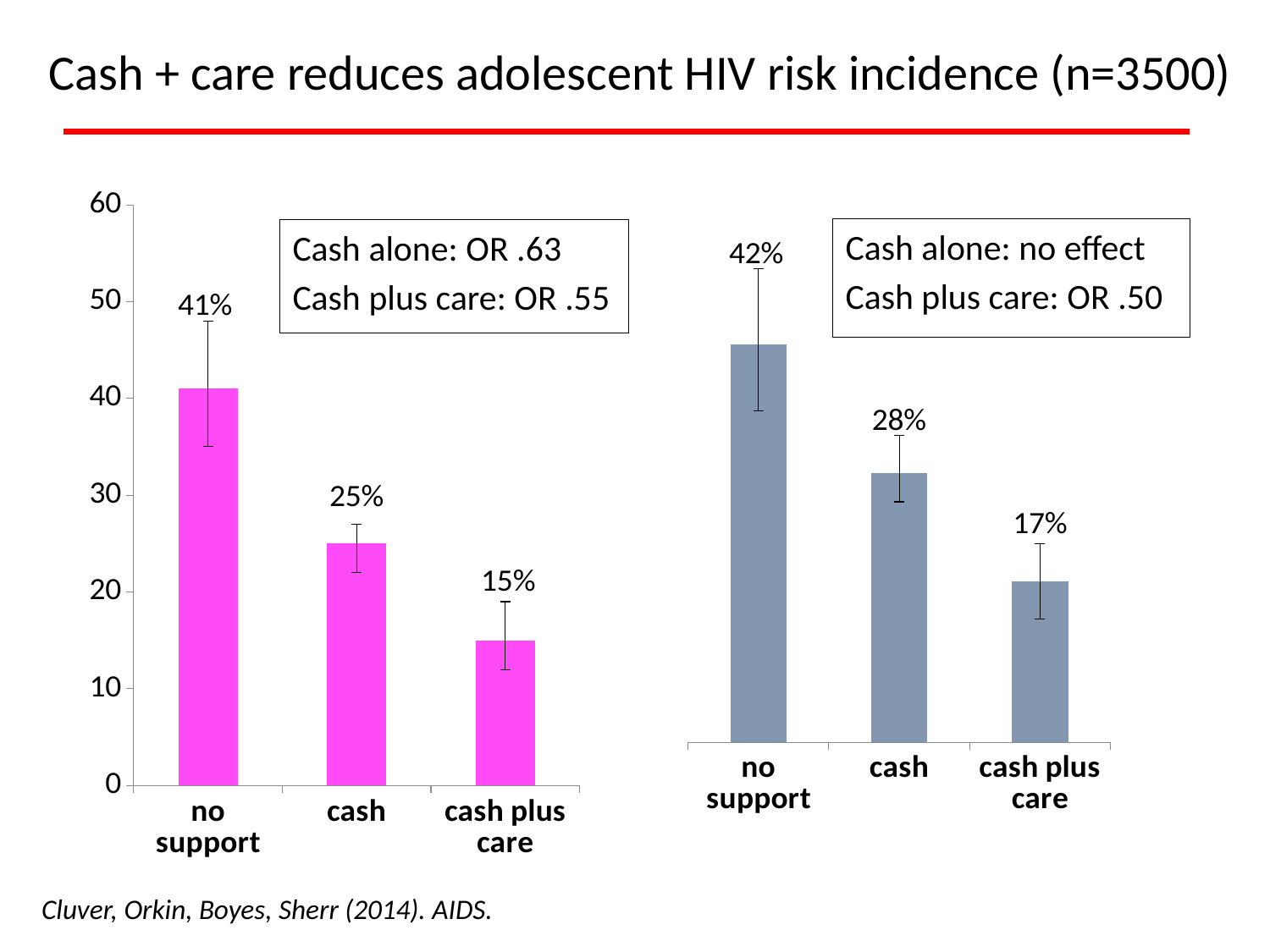
In the left chart, what is the value for 'cash plus care'? 15% In the right chart, what is the value for 'cash plus care'? 17% In the left chart, what is the difference between the values for 'no support' and 'cash plus care'? 26% In the left chart, do the values rise or fall from 'no support' to 'cash plus care'? fall In the left chart, what is the value for 'no support'? 41% How many categories are shown in the left chart? 3 In the right chart, which is larger, the value for 'cash' or the value for 'cash plus care'? cash In the right chart, what is the value for 'cash'? 28% In the right chart, what is the difference between the values for 'no support' and 'cash'? 14% In the right chart, which category has the lowest value? cash plus care In the left chart, which category has the highest value? no support What kind of chart is the right chart? bar chart